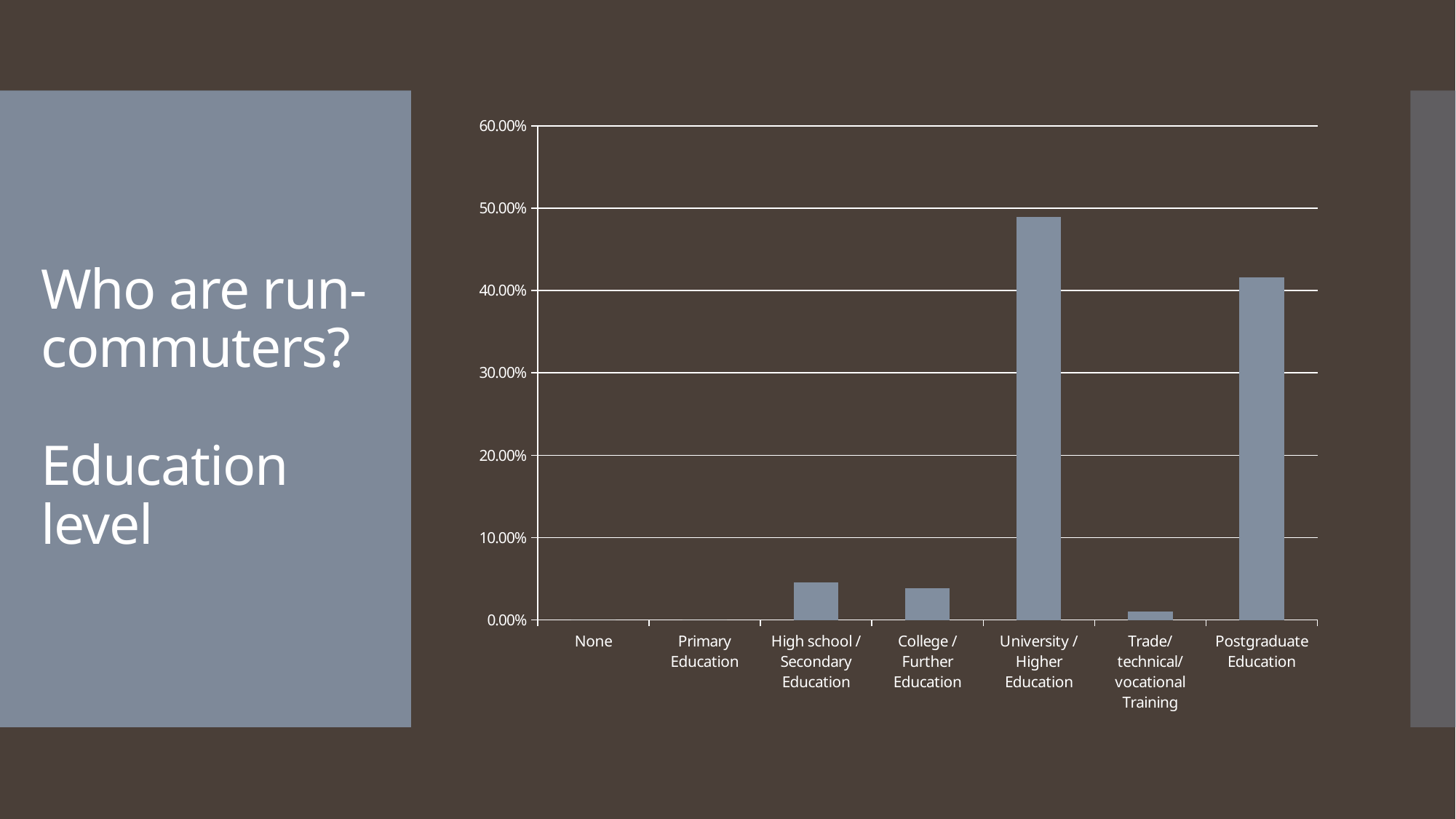
Which is larger, the value for University / Higher Education or the value for Postgraduate Education? University / Higher Education Is the value for University / Higher Education greater or less than 50.00%? less What is the highest value shown on the y axis of the chart? 60.00% Is the value for University / Higher Education greater or less than 40.00%? greater What kind of chart is shown on the slide? bar chart Is the value for Trade/technical/vocational Training greater or less than 10.00%? less Which is larger, the value for College / Further Education or the value for Postgraduate Education? Postgraduate Education How many education categories are shown on the x axis of the chart? 7 Which education category has the highest value in the chart? University / Higher Education